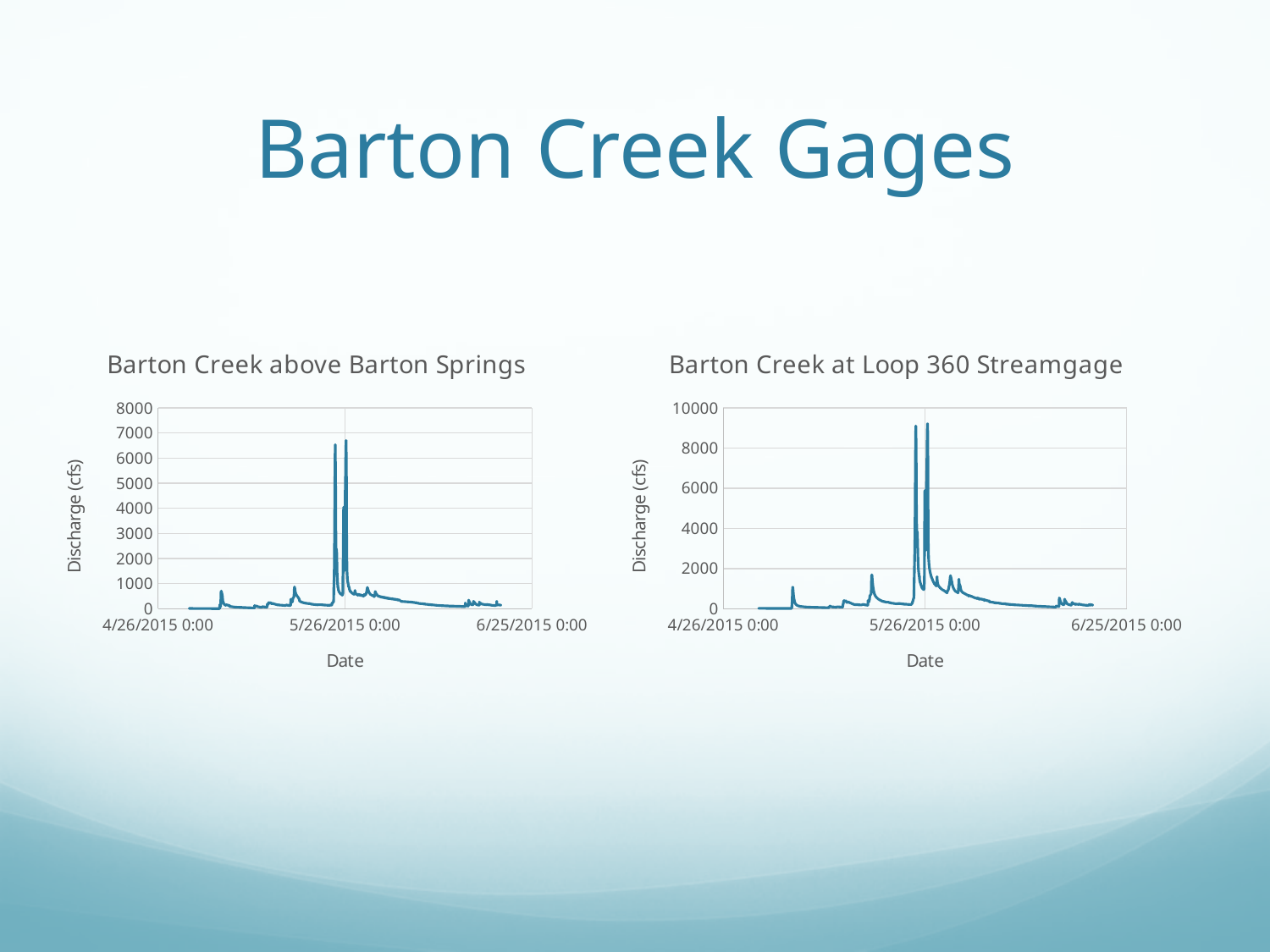
In the 'Barton Creek above Barton Springs' chart, is the highest discharge peak greater or less than 6000? greater What kind of chart is the 'Barton Creek above Barton Springs' chart? line chart What kind of chart is the 'Barton Creek at Loop 360 Streamgage' chart? line chart Which chart shows the higher maximum discharge peak, 'Barton Creek above Barton Springs' or 'Barton Creek at Loop 360 Streamgage'? Barton Creek at Loop 360 Streamgage In the 'Barton Creek above Barton Springs' chart, is the highest discharge peak greater or less than 7000? less In the 'Barton Creek at Loop 360 Streamgage' chart, is the highest discharge peak greater or less than 10000? less What is the y-axis label on the 'Barton Creek above Barton Springs' chart? Discharge (cfs) What is the x-axis label on the 'Barton Creek at Loop 360 Streamgage' chart? Date